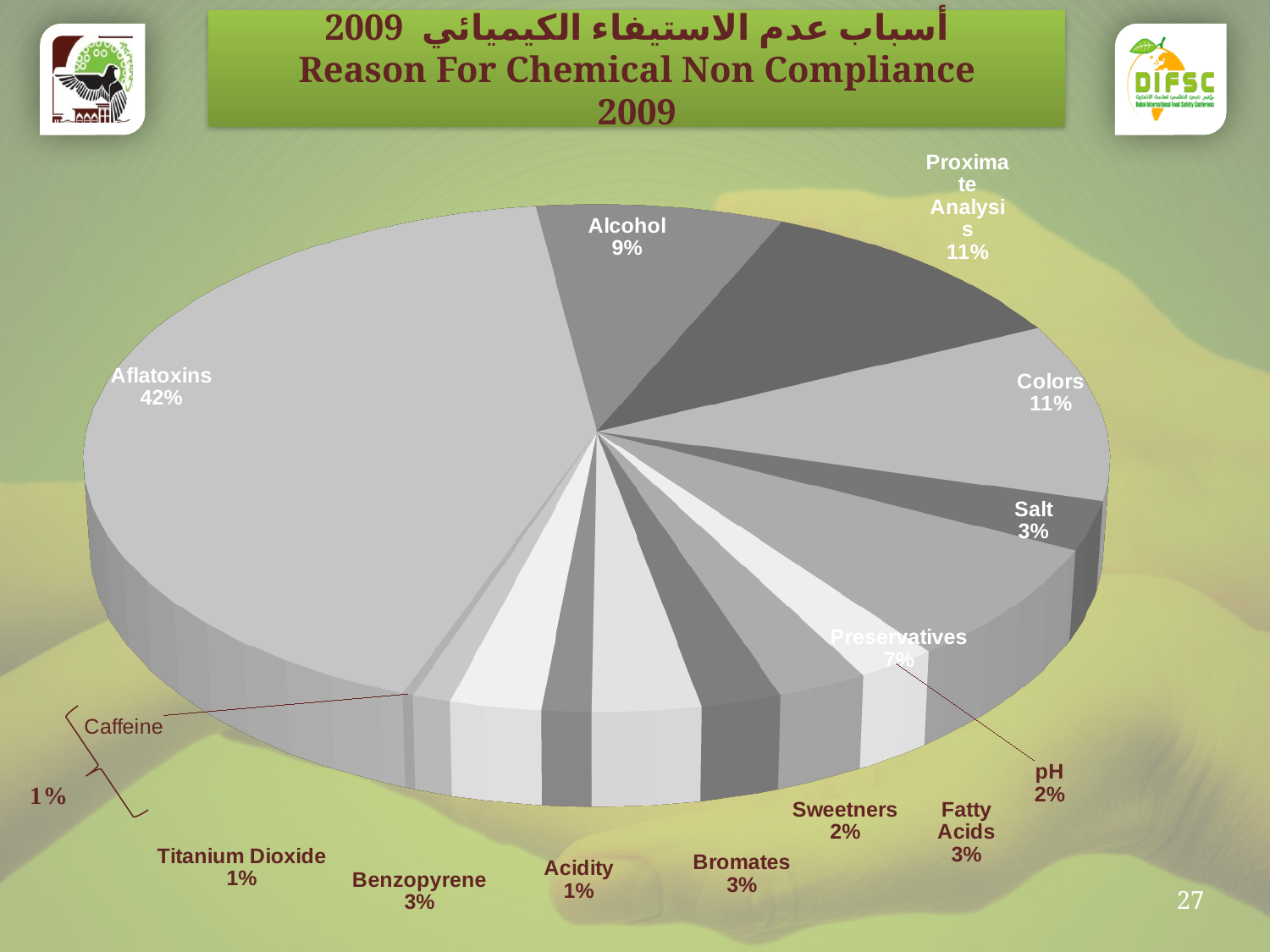
Which reason accounts for the largest share of chemical non compliance? Aflatoxins What is the value shown for Alcohol? 9% What is the title of the chart? Reason For Chemical Non Compliance 2009 What type of chart is shown on the slide? Pie chart How many categories (slices) are shown in the pie chart? 14 Which is larger, the share for Alcohol or the share for Preservatives? Alcohol What percentage is shown for Proximate Analysis? 11% What share does Preservatives have in the pie chart? 7% What percentage is shown for Salt? 3% What is the difference in percentage points between Aflatoxins and Colors? 31 What percentage of chemical non compliance is attributed to Aflatoxins? 42% What is the combined share of Colors and Proximate Analysis? 22%